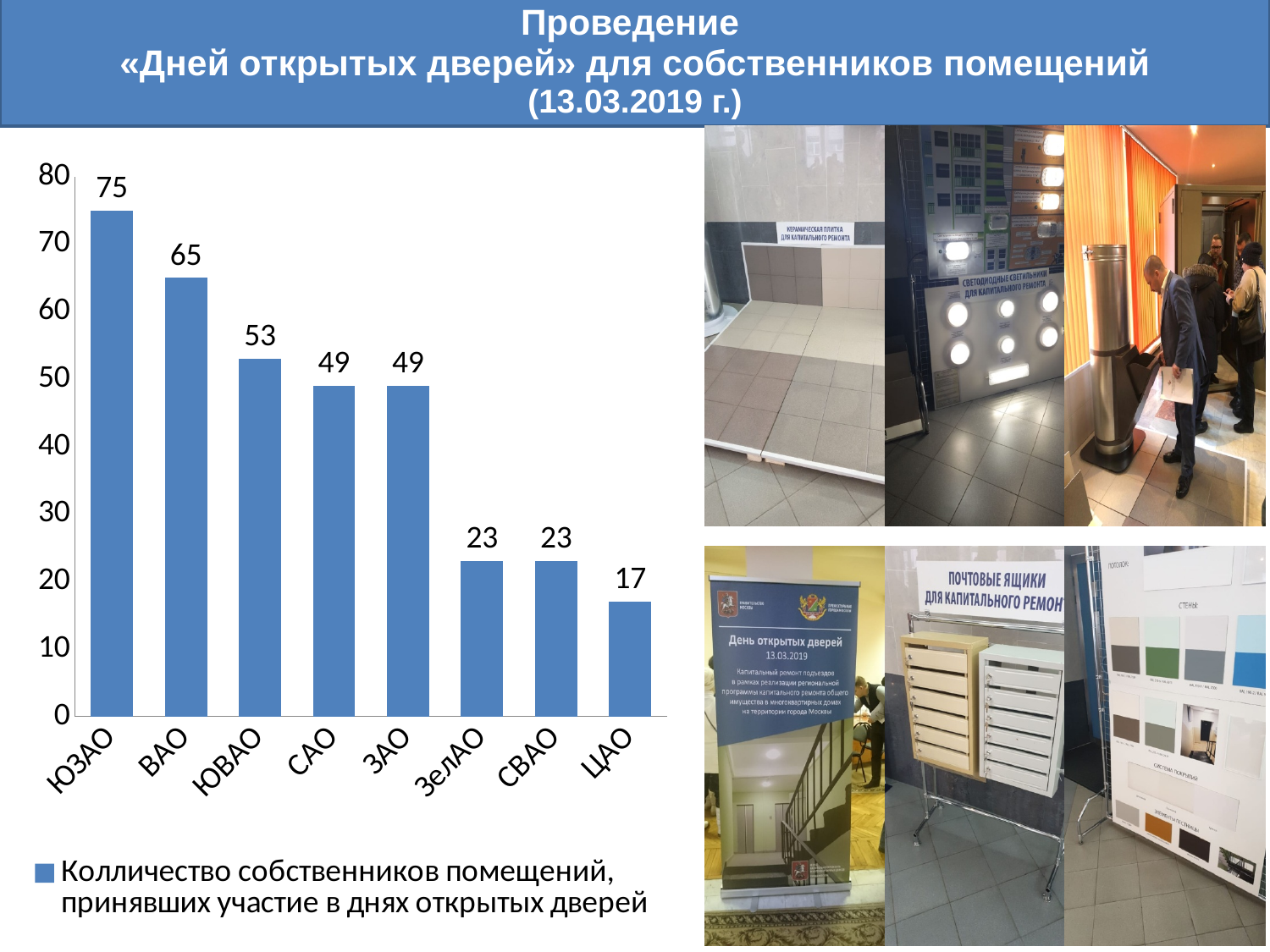
How many categories are shown on the x axis? 8 Do the values generally rise or fall from left to right along the x axis? fall Which category has the lowest value? ЦАО What is the value for ЮВАО? 53 What is the difference between the values for ЮЗАО and ВАО? 10 Which category has the highest value? ЮЗАО What kind of chart is shown on the slide? bar chart What is the difference between the values for ЮВАО and ЦАО? 36 What is the value for ЮЗАО? 75 How many series does the legend list? 1 What is the value for ЦАО? 17 Which is larger, the value for ВАО or the value for САО? ВАО